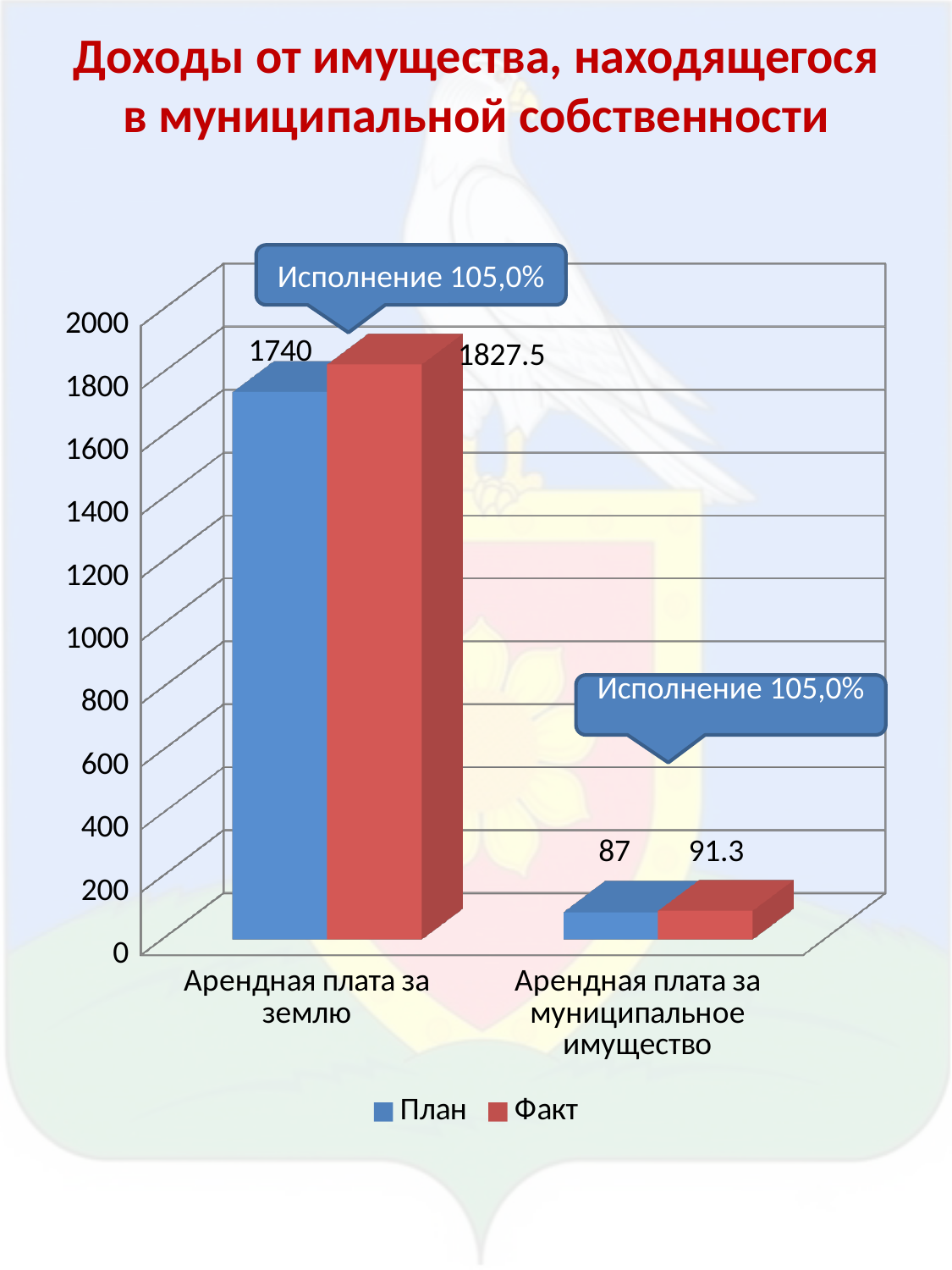
What is the difference between the Факт and План values for Арендная плата за муниципальное имущество? 4.3 What is the Факт value for Арендная плата за землю? 1827.5 How many series does the legend list? 2 Which category has the highest Факт value? Арендная плата за землю What kind of chart is shown on the slide? Bar chart What is the План value for Арендная плата за землю? 1740 What is the Факт value for Арендная плата за муниципальное имущество? 91.3 What is the difference between the Факт and План values for Арендная плата за землю? 87.5 Which category has the lowest План value? Арендная плата за муниципальное имущество What is the План value for Арендная плата за муниципальное имущество? 87 How many categories are shown on the x axis? 2 Which is larger for Арендная плата за землю, the План value or the Факт value? Факт